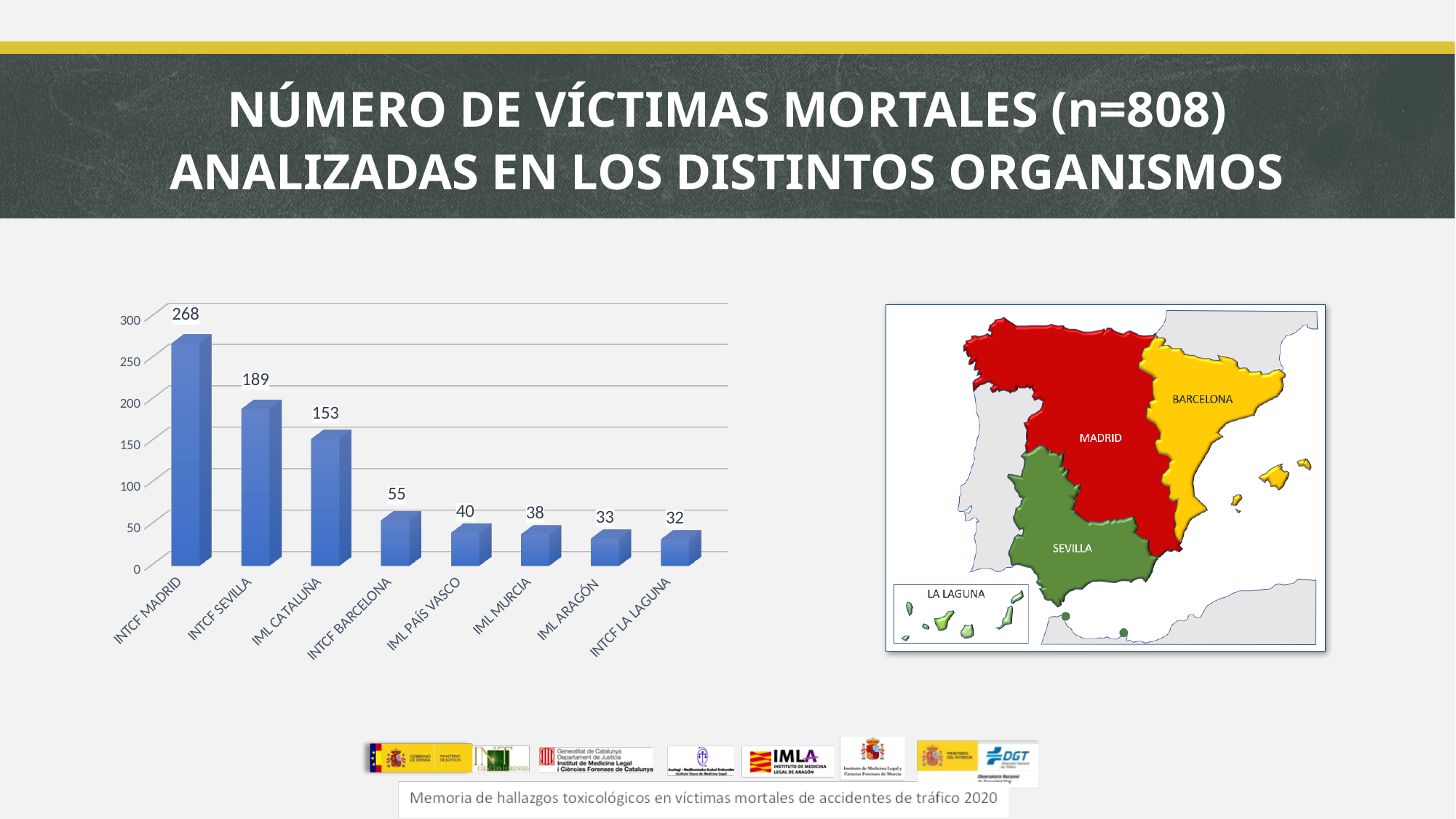
What is the difference between the values for INTCF MADRID and INTCF SEVILLA? 79 What is the value for INTCF LA LAGUNA? 32 What is the value for IML PAÍS VASCO? 40 What kind of chart is shown on the slide? bar chart Which is larger, the value for INTCF BARCELONA or the value for IML MURCIA? INTCF BARCELONA Is the value for INTCF SEVILLA greater or less than 150? greater Which category has the highest value? INTCF MADRID What is the value for INTCF MADRID? 268 What is the value for IML CATALUÑA? 153 How many categories are shown on the bar chart? 8 Which category has the lowest value? INTCF LA LAGUNA Do the values rise or fall from left to right along the x axis? fall